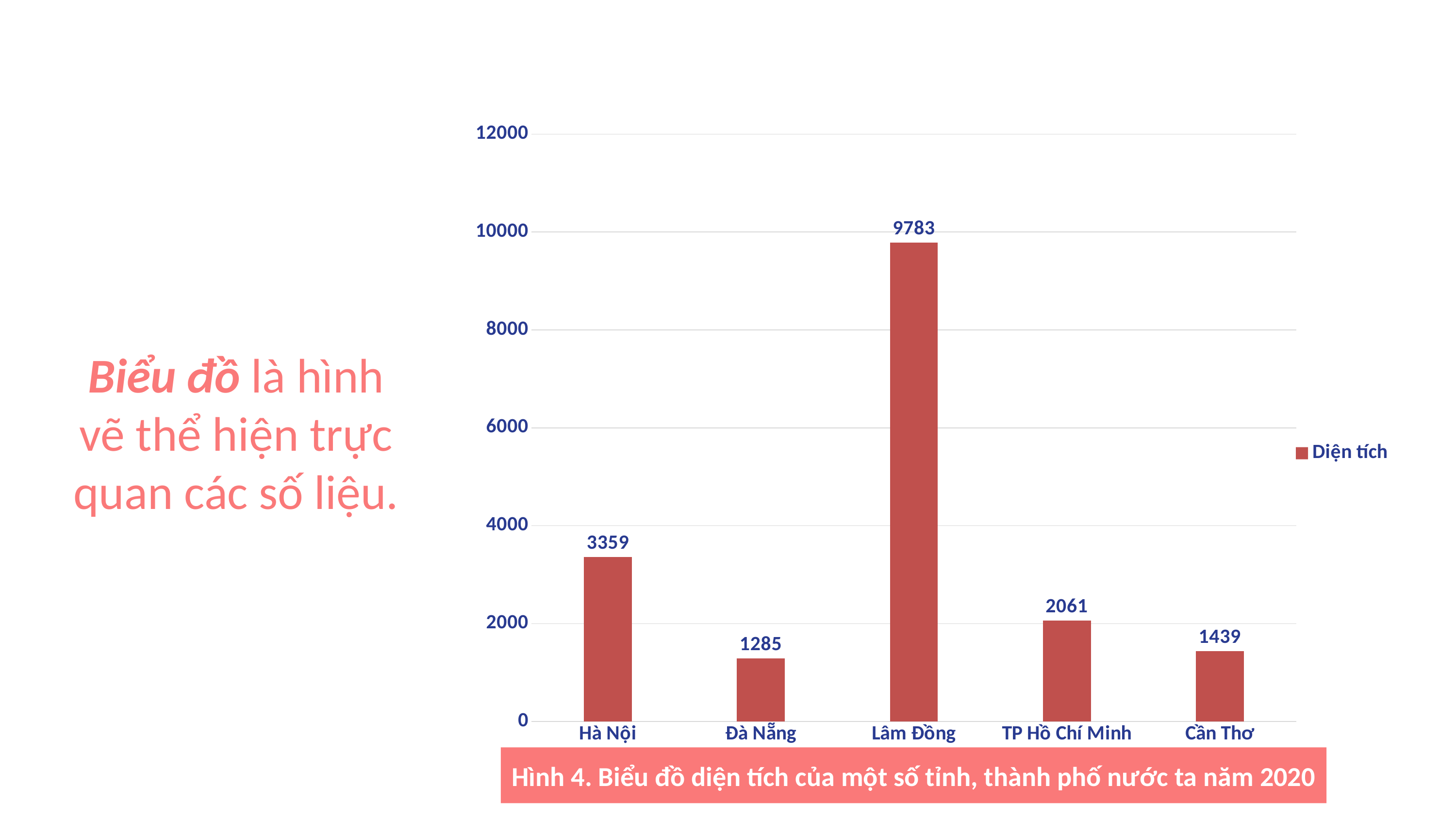
Is the value for Đà Nẵng greater or less than 2000? less What is the difference between the values for Lâm Đồng and Hà Nội? 6424 Which is larger, the value for Hà Nội or the value for TP Hồ Chí Minh? Hà Nội Which category has the lowest value? Đà Nẵng What is the difference between the values for TP Hồ Chí Minh and Cần Thơ? 622 What series name does the legend show? Diện tích What kind of chart is shown on the slide? bar chart What is the value for Hà Nội? 3359 How many categories are shown on the x axis? 5 What is the value for Lâm Đồng? 9783 What is the value for Cần Thơ? 1439 Which category has the highest value? Lâm Đồng